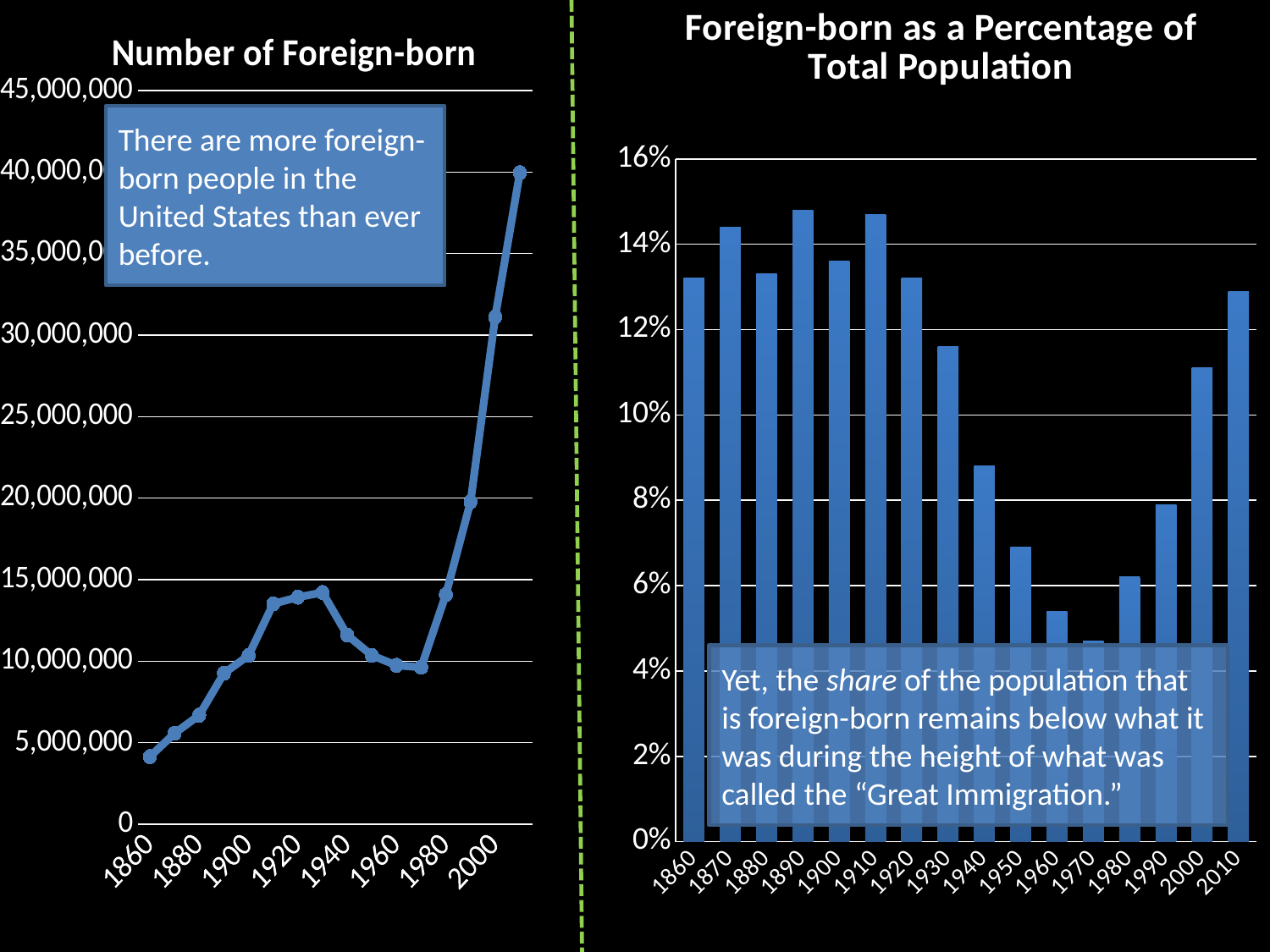
In the "Foreign-born as a Percentage of Total Population" chart, which year has the lowest value? 1970 How many bars are plotted in the "Foreign-born as a Percentage of Total Population" chart? 16 In the "Foreign-born as a Percentage of Total Population" chart, is the value for 1970 greater or less than 6%? less What kind of chart is the "Number of Foreign-born" chart on the left? line chart In the "Number of Foreign-born" chart, which year has the lowest value? 1860 In the "Foreign-born as a Percentage of Total Population" chart, which is larger, the value for 1930 or the value for 1940? 1930 In the "Number of Foreign-born" chart, is the value for 2010 greater or less than 35,000,000? greater In the "Number of Foreign-born" chart, is the value for 1860 greater or less than 5,000,000? less In the "Number of Foreign-born" chart, which is larger, the value for 1990 or the value for 2000? 2000 In the "Number of Foreign-born" chart, which year has the highest value? 2010 What kind of chart is the "Foreign-born as a Percentage of Total Population" chart on the right? bar chart